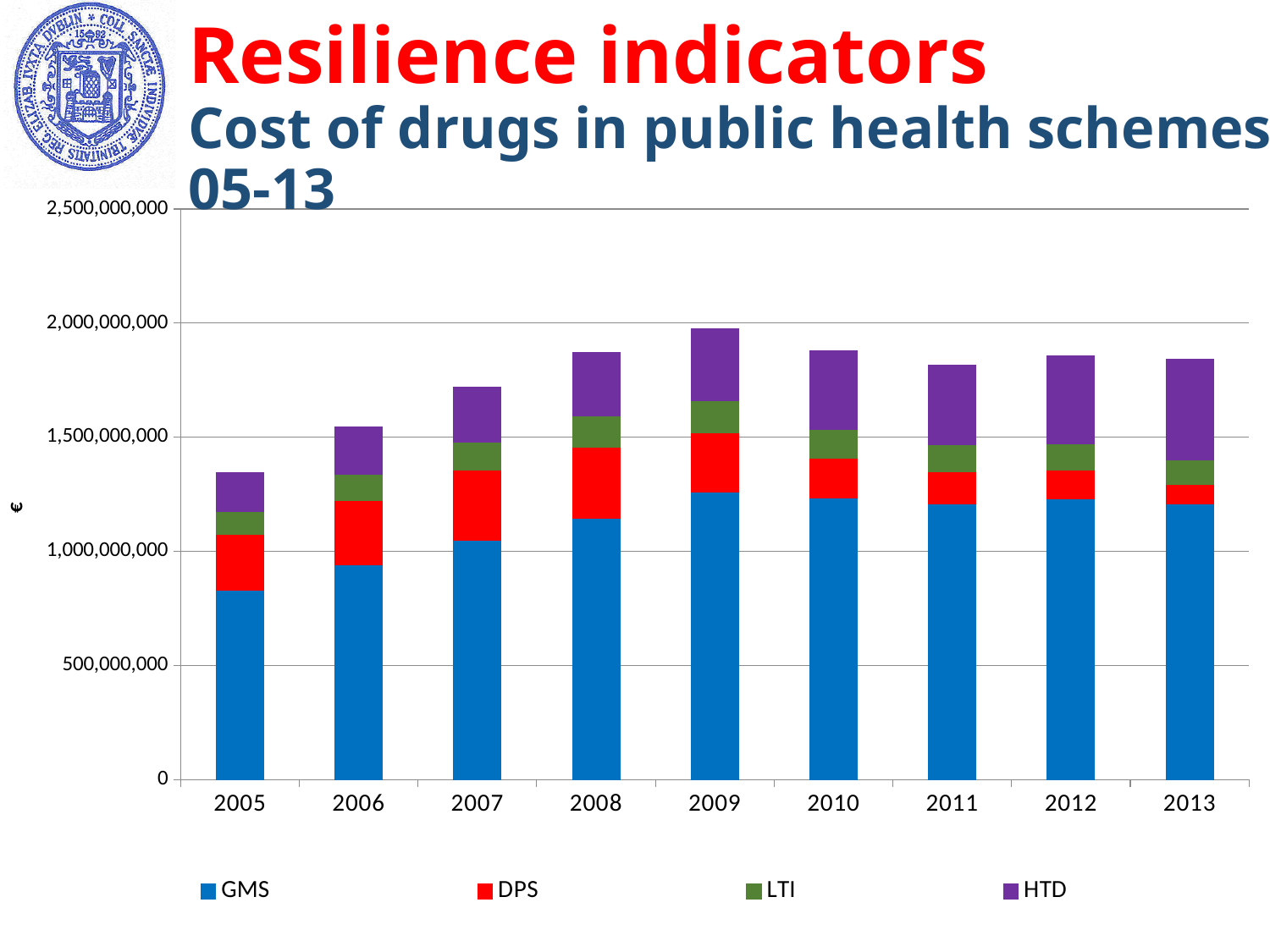
Is the total cost for 2005 greater or less than 1,500,000,000? less Is the total cost for 2013 greater or less than 1,500,000,000? greater Is the GMS value for 2005 greater or less than 1,000,000,000? less How many years are shown on the x axis of the chart? 9 How many series does the chart's legend list? 4 Which series is shown in purple in the legend? HTD What kind of chart is shown on the slide? Stacked bar chart Which year has the shortest stacked bar (lowest total cost)? 2005 Which year has the larger total cost, 2007 or 2008? 2008 Which year has the tallest stacked bar (highest total cost)? 2009 Do the total costs rise or fall from 2005 to 2009? rise